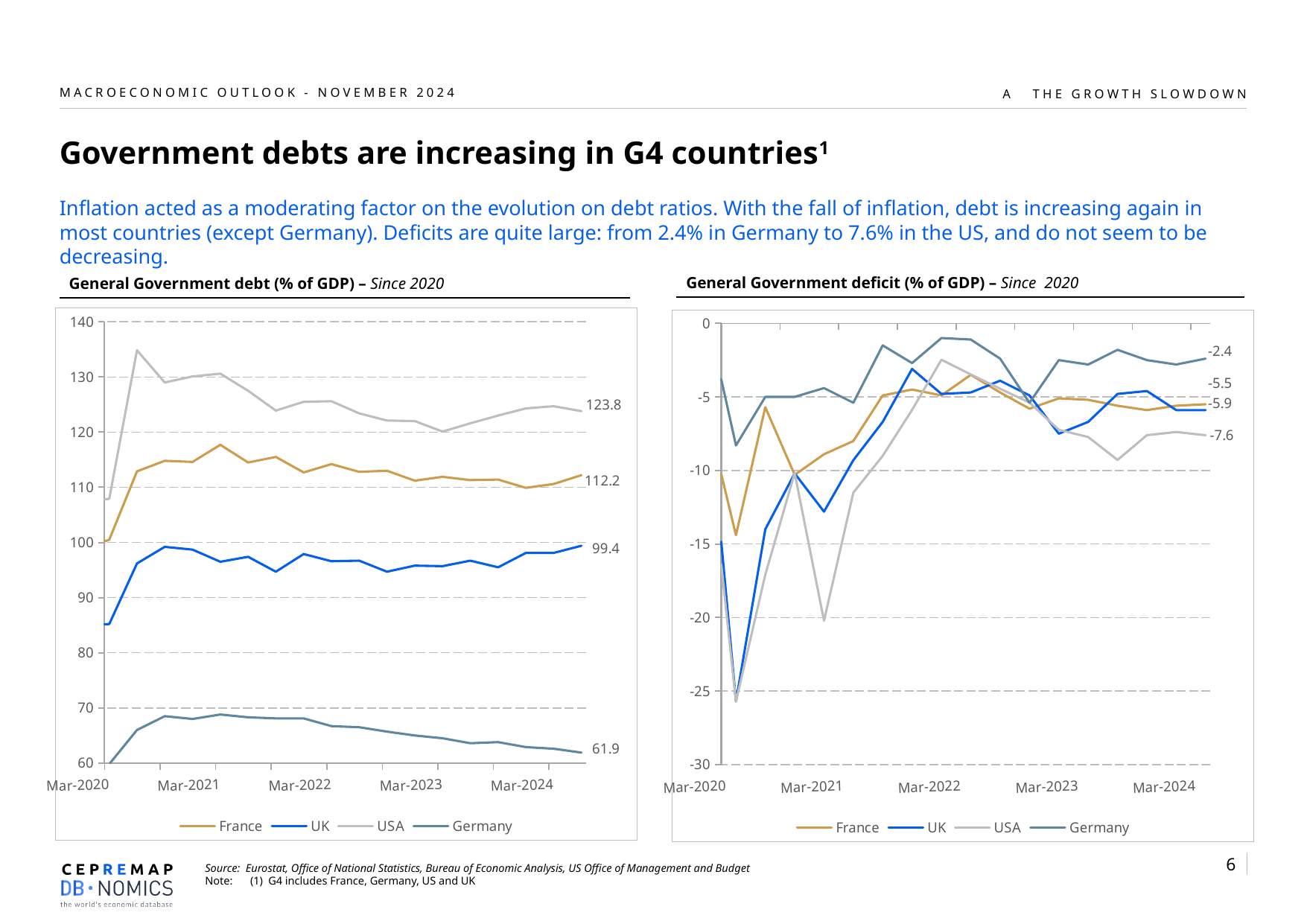
In the 'General Government debt (% of GDP)' chart, what is the latest labelled value for the UK? 99.4 In the 'General Government debt (% of GDP)' chart, is the UK value at Mar-2020 greater or less than 90? less How many series does the legend of the 'General Government debt (% of GDP)' chart list? 4 In the 'General Government debt (% of GDP)' chart, what is the latest labelled value for Germany? 61.9 In the 'General Government debt (% of GDP)' chart, which country has the highest debt ratio at the end of the series? USA In the 'General Government debt (% of GDP)' chart, which country has the lowest debt ratio at the end of the series? Germany In the 'General Government debt (% of GDP)' chart, what is the latest labelled value for France? 112.2 In the 'General Government debt (% of GDP)' chart, what is the latest labelled value for the USA? 123.8 In the 'General Government deficit (% of GDP)' chart, what is the latest labelled value for the USA? -7.6 In the 'General Government debt (% of GDP)' chart, what is the difference between the latest labelled values for the USA and Germany? 61.9 In the 'General Government deficit (% of GDP)' chart, what is the latest labelled value for Germany? -2.4 What kind of chart is the 'General Government debt (% of GDP)' chart on the left? Line chart